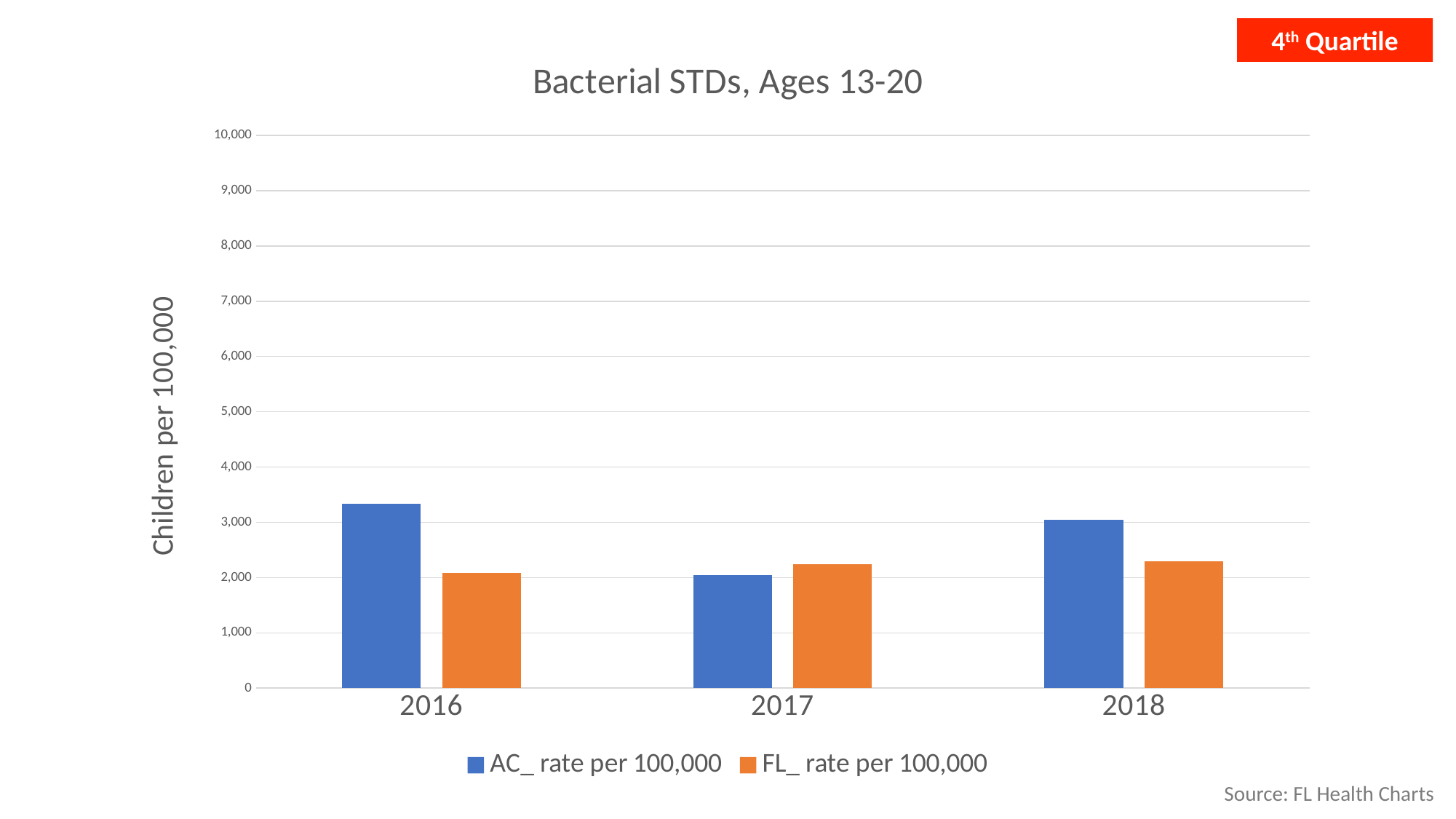
Is the FL_ rate per 100,000 for 2017 greater or less than 3,000? less Is the FL_ rate per 100,000 for 2018 greater or less than 2,000? greater What kind of chart is shown on the slide? bar chart In which year is the AC_ rate per 100,000 highest? 2016 Does the AC_ rate per 100,000 rise or fall from 2016 to 2017? fall In 2016, which is larger: the AC_ rate per 100,000 or the FL_ rate per 100,000? AC_ rate per 100,000 In 2017, which is larger: the AC_ rate per 100,000 or the FL_ rate per 100,000? FL_ rate per 100,000 How many years are shown on the x axis? 3 In which year is the AC_ rate per 100,000 lowest? 2017 How many series does the legend list? 2 Is the AC_ rate per 100,000 for 2016 greater or less than 3,000? greater What is the title of the chart? Bacterial STDs, Ages 13-20